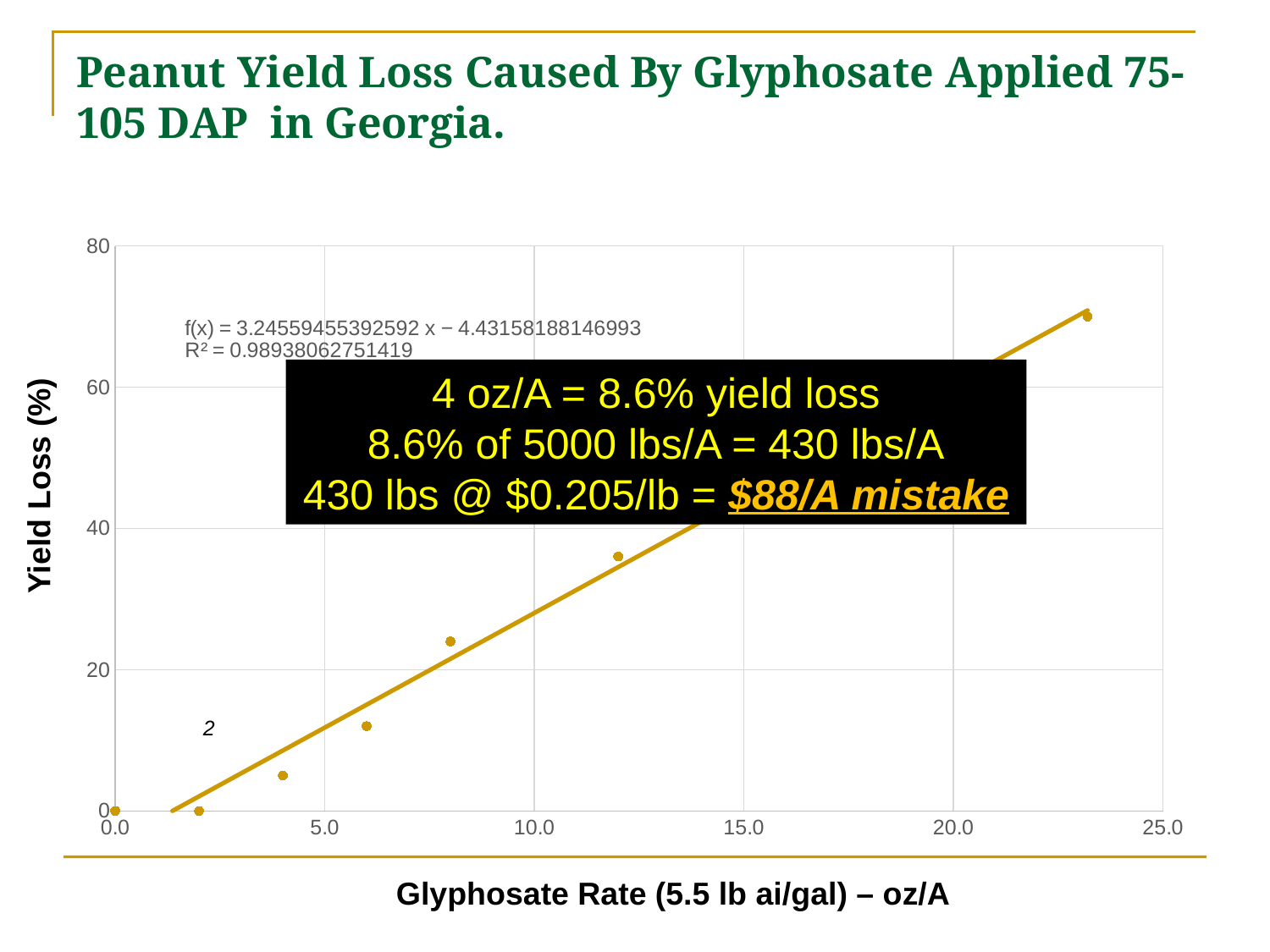
Do the yield loss values rise or fall as the glyphosate rate increases along the x axis? Rise Is the yield loss at a glyphosate rate of 8.0 greater or less than 20? greater Is the yield loss for the rightmost data point greater or less than 60? greater What kind of chart is shown on the slide? Scatter chart Which has the larger yield loss: the point at a rate of 4.0 or the point at a rate of 6.0? The point at 6.0 Which has the larger yield loss: the point at a rate of 12.0 or the point at a rate of 8.0? The point at 12.0 What R² value is printed for the trendline on the chart? 0.98938062751419 Is the yield loss at a glyphosate rate of 12.0 greater or less than 40? less What is the title of the x axis? Glyphosate Rate (5.5 lb ai/gal) – oz/A